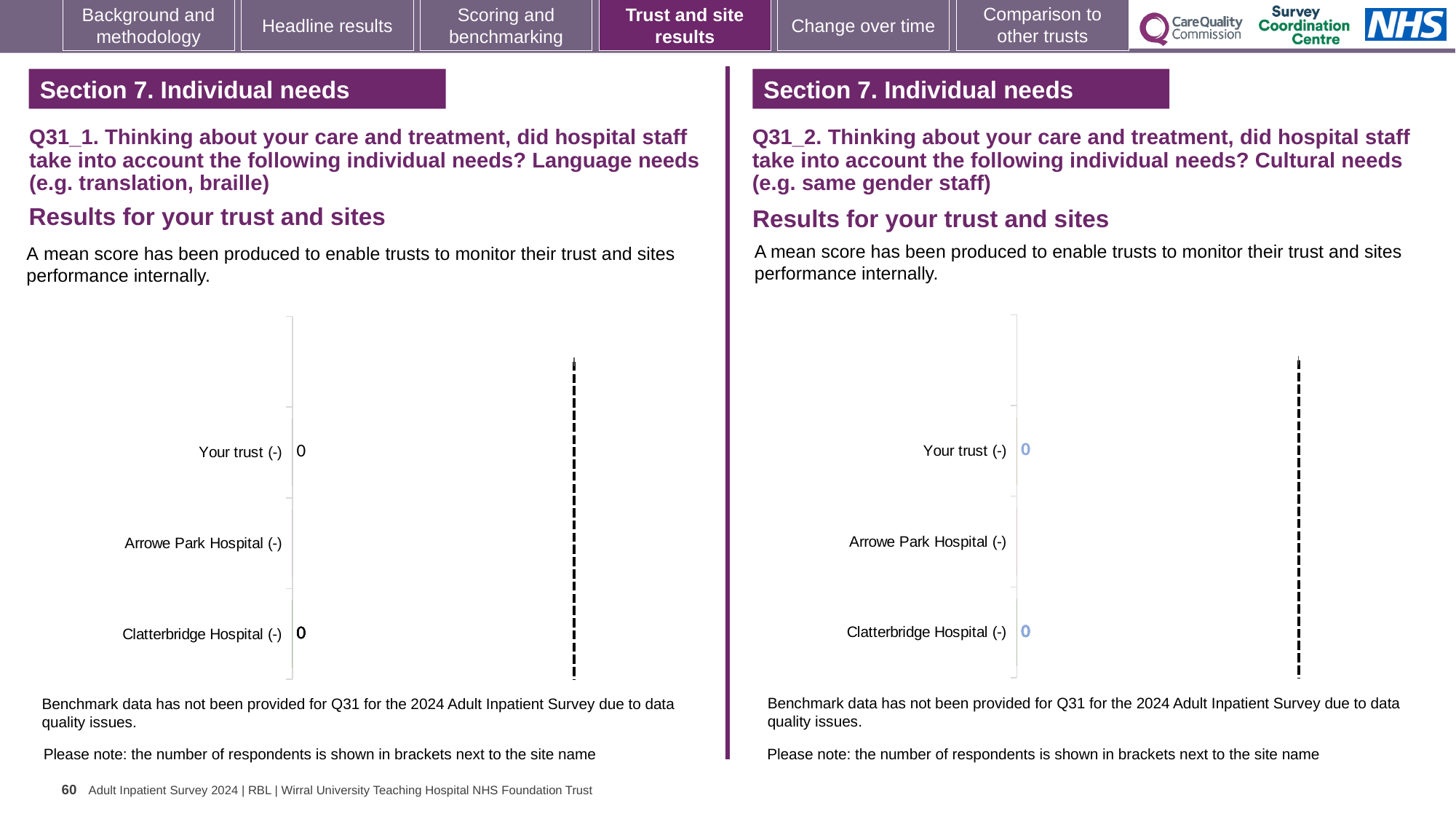
On the left chart (Q31_1, Language needs), what is shown in brackets next to each site name as the number of respondents? - On the left chart (Q31_1, Language needs), what value is shown for Your trust (-)? 0 On the left chart (Q31_1, Language needs), what is the difference between the values for Your trust (-) and Clatterbridge Hospital (-)? 0 On the left chart (Q31_1, Language needs), what value is shown for Clatterbridge Hospital (-)? 0 On the right chart (Q31_2, Cultural needs), what value is shown for Clatterbridge Hospital (-)? 0 On the right chart (Q31_2, Cultural needs), which category has no data label shown next to it? Arrowe Park Hospital (-) On the left chart (Q31_1, Language needs), how many categories are listed on the vertical axis? 3 On the right chart (Q31_2, Cultural needs), what value is shown for Your trust (-)? 0 On the right chart (Q31_2, Cultural needs), how many categories are listed on the vertical axis? 3